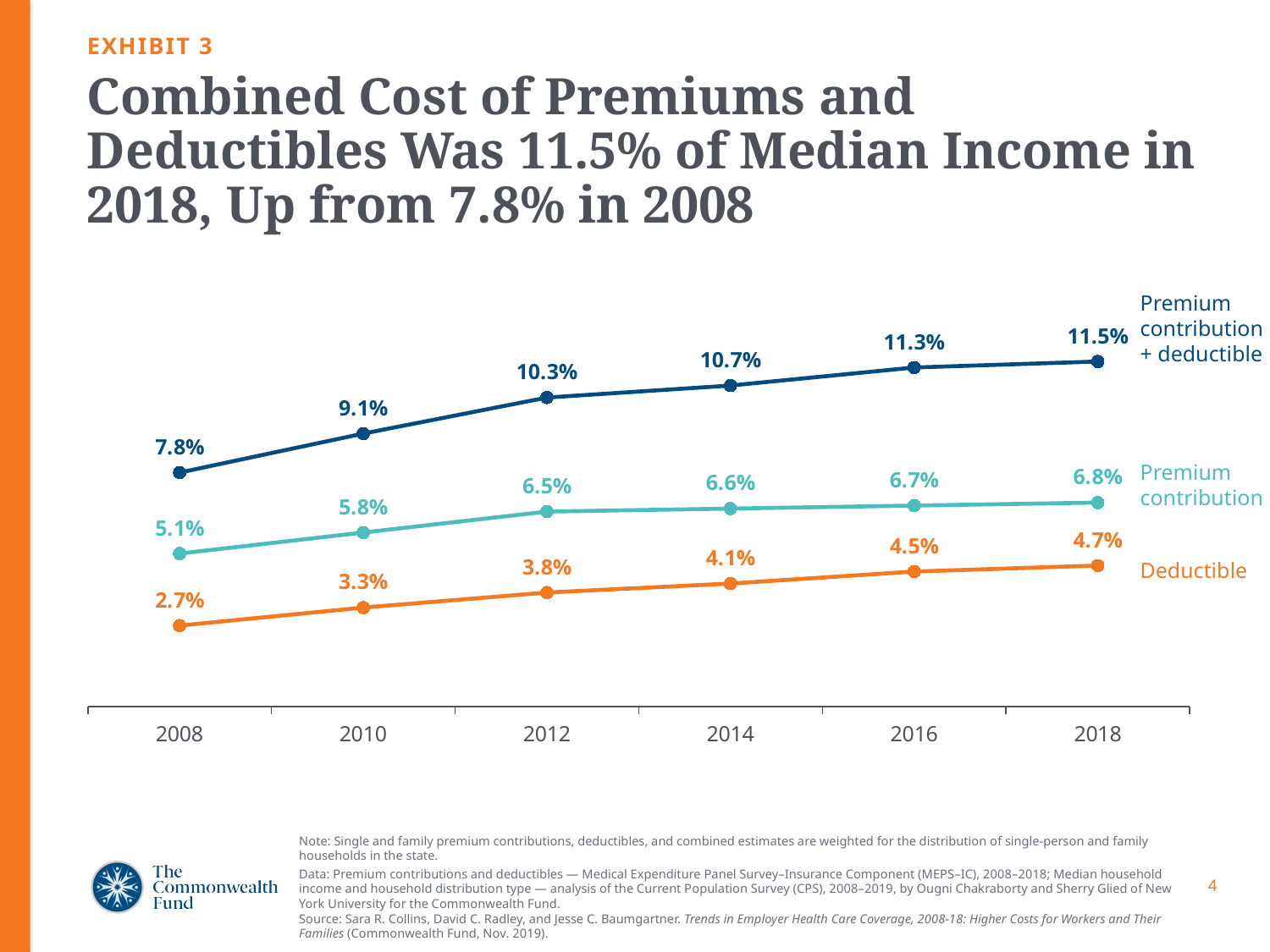
What kind of chart is shown on the slide? Line chart What colour is the Deductible line? Orange How many years are shown on the x axis? 6 Does the Deductible series rise or fall from 2008 to 2018? Rise Which was larger in 2014: Premium contribution or Deductible? Premium contribution What was the Deductible value in 2008? 2.7% How many series are plotted on the chart? 3 What is the difference between the Premium contribution + deductible values in 2018 and 2008? 3.7% What was the Premium contribution value in 2012? 6.5% What was the value for Premium contribution + deductible in 2018? 11.5% In which year was the Premium contribution + deductible series lowest? 2008 In which year was the Deductible series highest? 2018